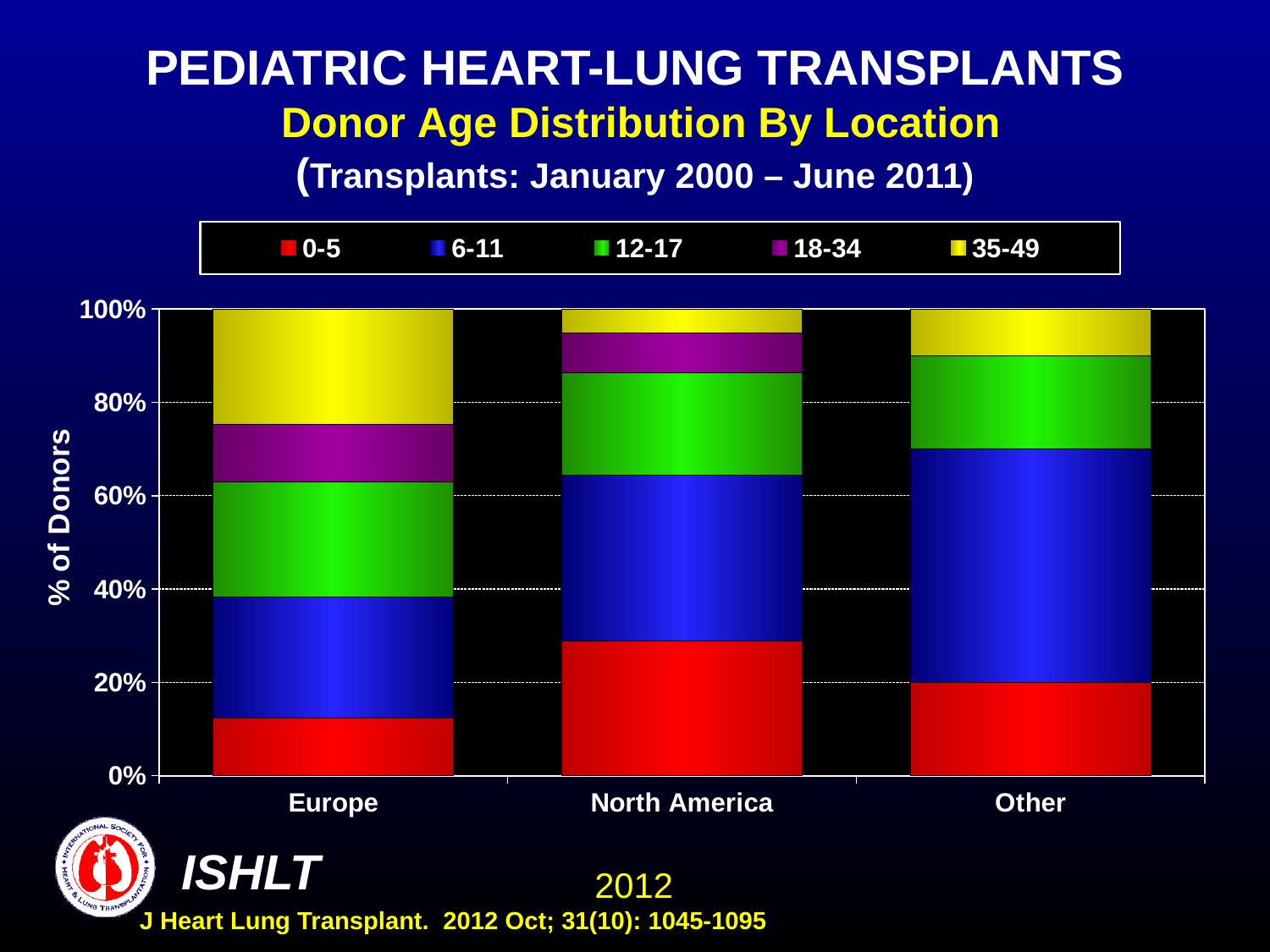
Which location has no 18-34 donor age segment in its bar? Other How many locations are shown on the x axis? 3 Is the share of donors aged 35-49 in North America greater or less than 20%? less What kind of chart is shown on the slide? Stacked bar chart Which location has the largest share of donors aged 6-11? Other Which location has the largest share of donors aged 35-49? Europe How many donor age groups does the legend list? 5 Which location has the largest share of donors aged 0-5? North America Is the share of donors aged 0-5 in Europe greater or less than 20%? less Is the share of donors aged 6-11 in Other greater or less than 40%? greater Is the share of donors aged 0-5 larger in Europe or in North America? North America